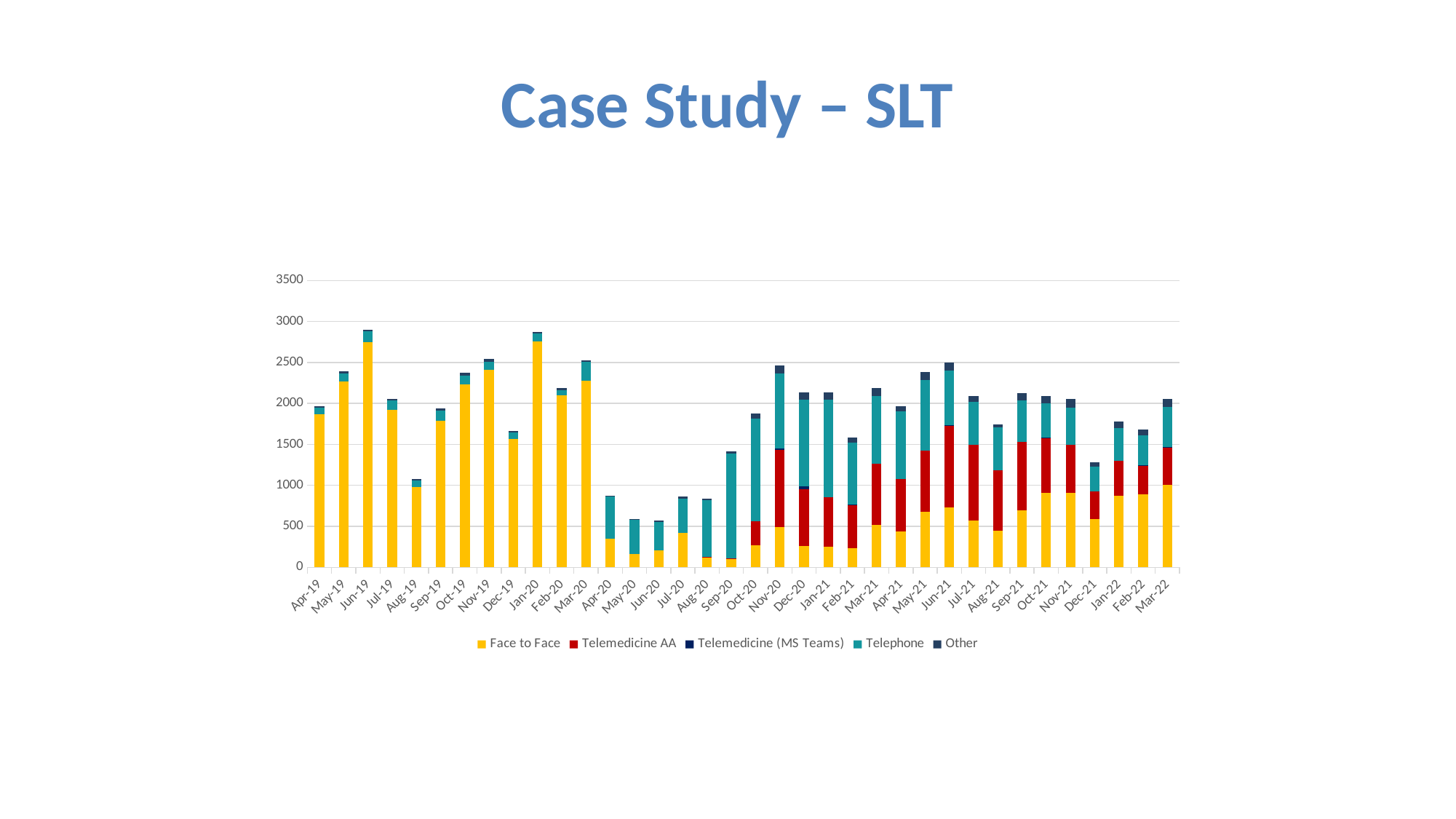
What is the title of the slide? Case Study – SLT Is the total for Jun-19 greater or less than 2500? greater Which month has the larger total, Apr-20 or Oct-20? Oct-20 Which month has the larger total, Jun-19 or Aug-19? Jun-19 Do the bar totals rise or fall from Mar-20 to May-20? fall What kind of chart is shown on the slide? Stacked bar chart Which series is shown in yellow? Face to Face Is the total for Apr-19 greater or less than 1500? greater How many months are shown along the x axis? 36 Is the total for May-20 greater or less than 1000? less How many series does the legend list? 5